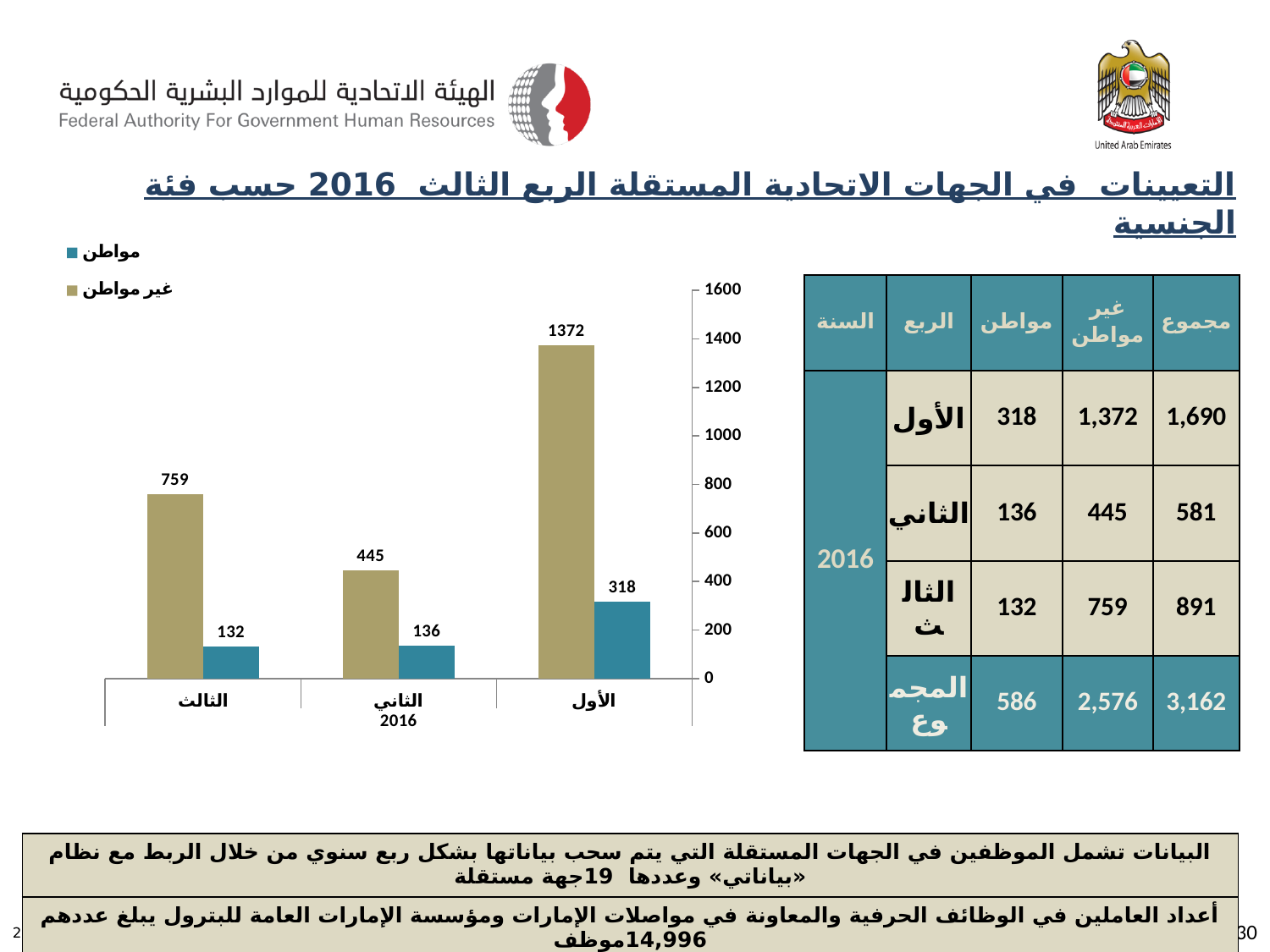
Which is larger: the مواطن value for الثاني or the مواطن value for الثالث? الثاني What is the value for غير مواطن in الثاني? 445 What is the value for مواطن in الثالث? 132 What kind of chart is shown on the slide? bar chart How many series does the legend list? 2 What is the difference between the غير مواطن values for الأول and الثالث? 613 How many categories are shown on the x axis of the chart? 3 What is the value for غير مواطن in الأول? 1372 Which category has the highest value for غير مواطن? الأول What is the value for مواطن in الأول? 318 Which category has the lowest value for مواطن? الثالث Is the value for غير مواطن in الثالث greater or less than 600? greater